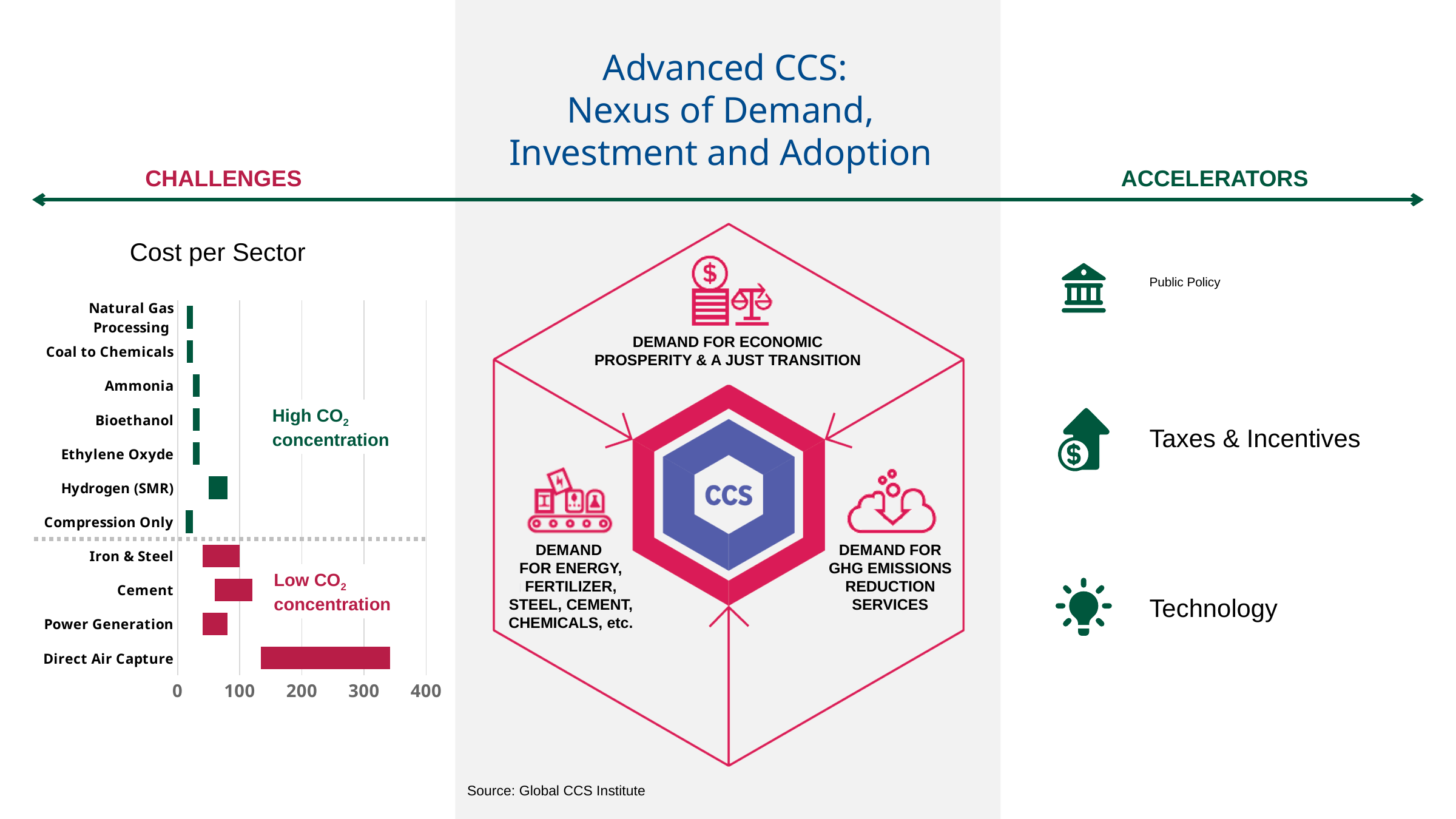
On the Cost per Sector chart, which bar extends further to the right: Iron & Steel or Hydrogen (SMR)? Iron & Steel Which sector has the highest cost shown on the Cost per Sector chart? Direct Air Capture How many sectors on the Cost per Sector chart are grouped under Low CO2 concentration? 4 On the Cost per Sector chart, which bar extends further to the right: Cement or Power Generation? Cement What is the highest value shown on the x axis of the Cost per Sector chart? 400 On the Cost per Sector chart, is the upper end of the Cement bar greater or less than 200? less What kind of chart is the Cost per Sector chart? bar chart On the Cost per Sector chart, is the cost for Natural Gas Processing greater or less than 100? less On the Cost per Sector chart, is the upper end of the Direct Air Capture bar greater or less than 300? greater What is the title of the chart on the left of the slide? Cost per Sector How many sectors are listed on the Cost per Sector chart? 11 On the Cost per Sector chart, what colour are the bars for the High CO2 concentration sectors? green